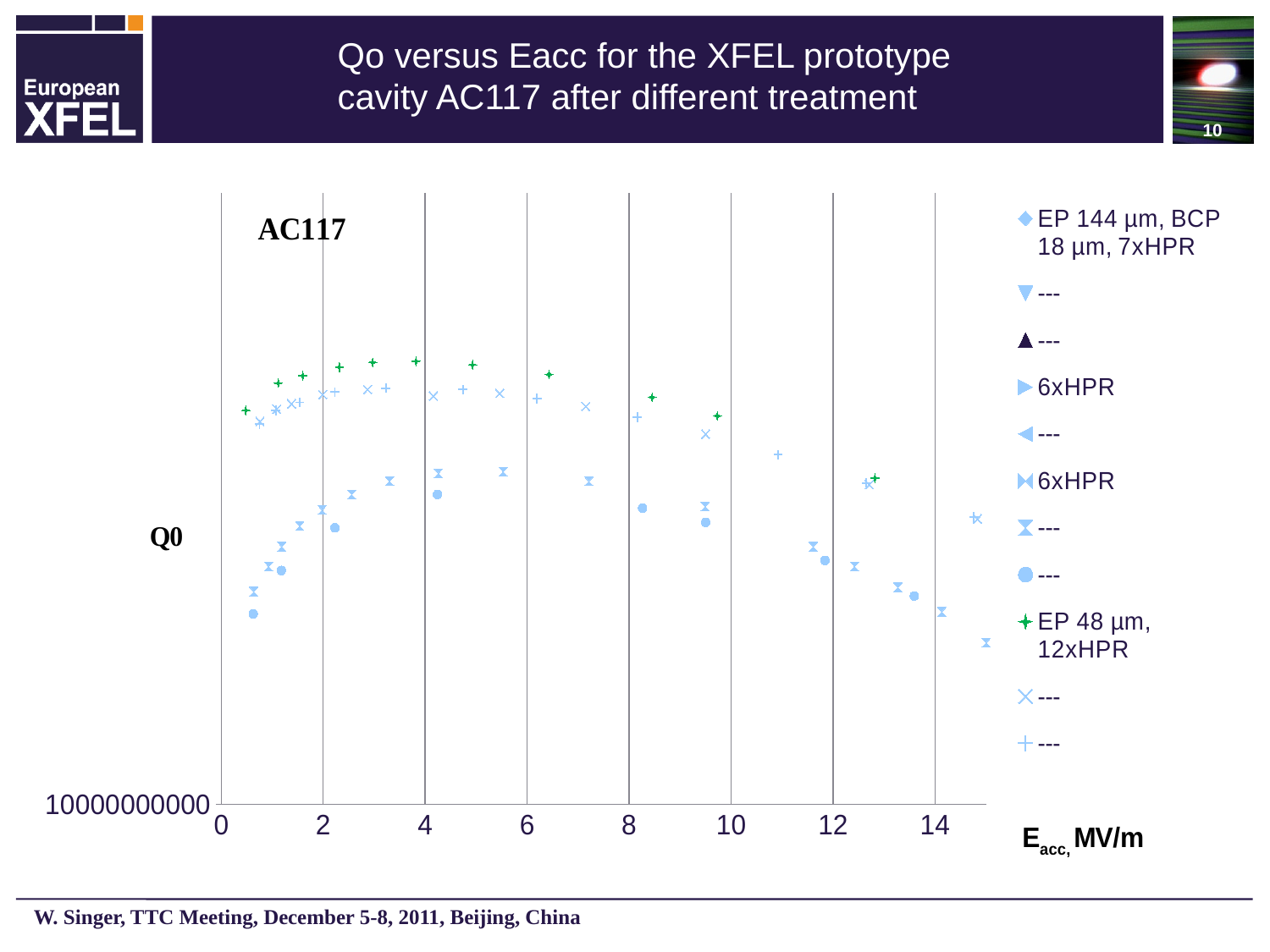
Which legend entry uses the green cross marker? EP 48 µm, 12xHPR What label is printed inside the plot area as the chart title? AC117 What is the only value labelled on the y axis? 10000000000 What kind of chart is shown on the slide? scatter chart How many legend entries are labelled only with '---'? 7 How many series does the legend list? 11 Does Q0 for the EP 48 µm, 12xHPR series rise or fall as Eacc increases from 0 to 4 MV/m? rise Does Q0 for the EP 48 µm, 12xHPR series rise or fall as Eacc increases from 6 to 10 MV/m? fall Which legend series reaches the highest Q0 values on the chart? EP 48 µm, 12xHPR